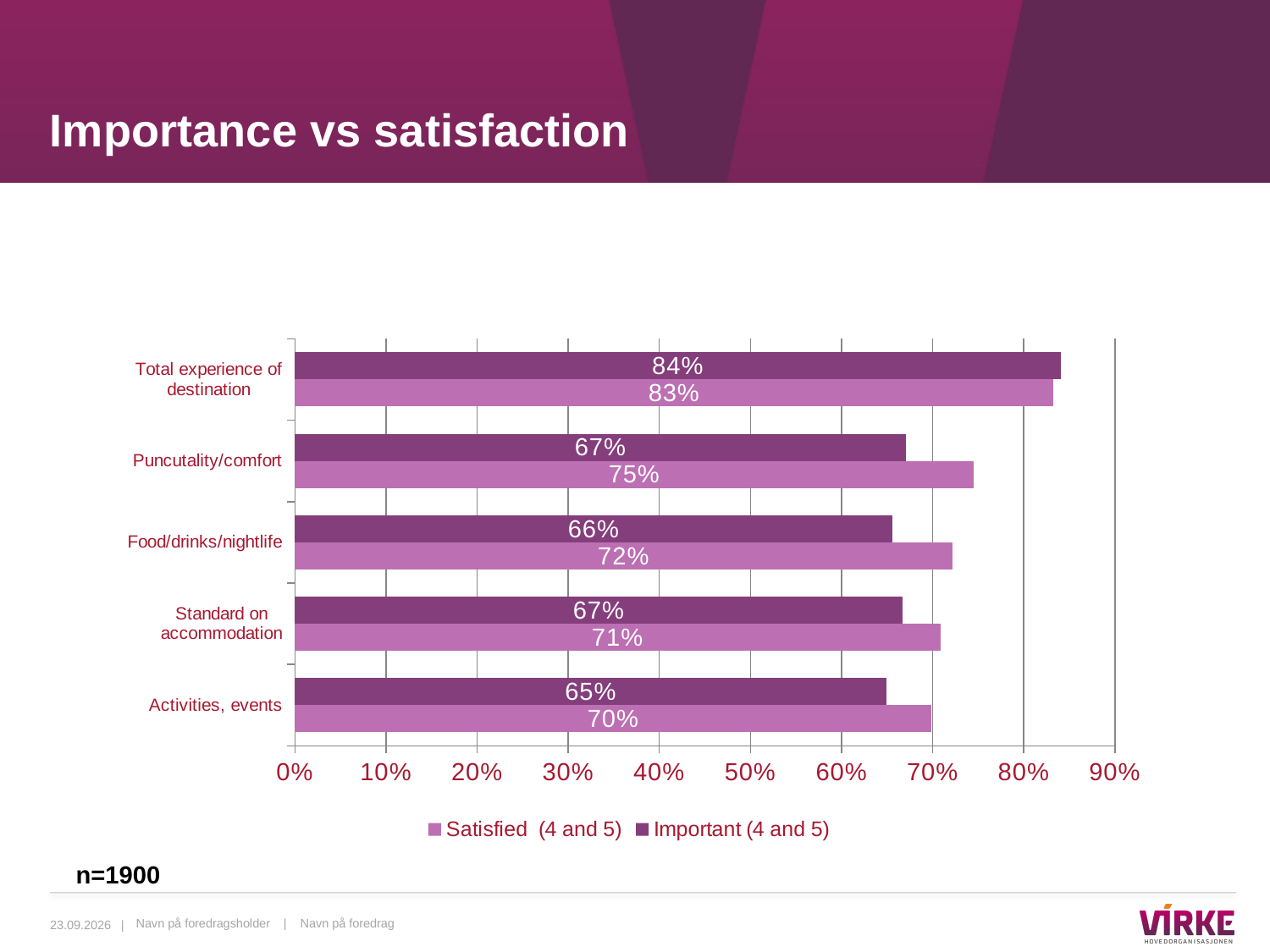
How many series does the legend list? 2 Which category has the lowest Important (4 and 5) value? Activities, events What is the Satisfied (4 and 5) value for Activities, events? 70% For Standard on accommodation, which is larger: the Satisfied (4 and 5) value or the Important (4 and 5) value? Satisfied (4 and 5) What is the title of the slide containing the chart? Importance vs satisfaction What is the difference between the Satisfied (4 and 5) and Important (4 and 5) values for Puncutality/comfort? 8% What is the Satisfied (4 and 5) value for Puncutality/comfort? 75% How many categories are shown on the chart? 5 What is the Important (4 and 5) value for Food/drinks/nightlife? 66% What kind of chart is shown on the slide? Bar chart Which category has the highest Satisfied (4 and 5) value? Total experience of destination What is the Important (4 and 5) value for Total experience of destination? 84%